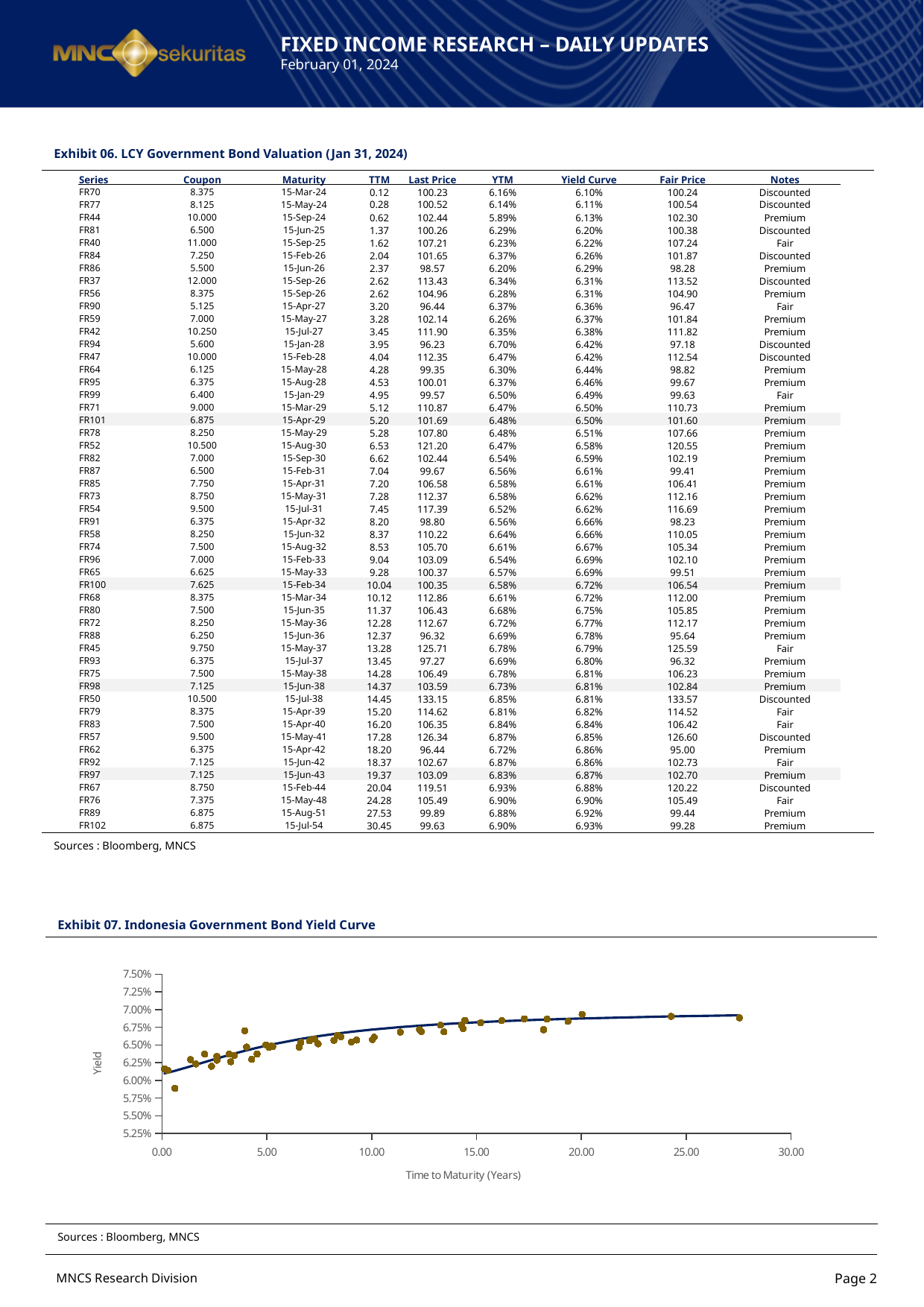
In Exhibit 07, is the fitted yield curve at 10 years to maturity greater or less than 6.25%? greater In Exhibit 07, is the yield of the outlying point near 4 years to maturity greater or less than 6.50%? greater In Exhibit 07, is the fitted yield curve at 25 years to maturity greater or less than 7.00%? less What is the title of the chart on the slide? Exhibit 07. Indonesia Government Bond Yield Curve In Exhibit 07, which has the higher yield: the point near 0.5 years to maturity or the point near 27.5 years to maturity? The point near 27.5 years What is the label of the x axis in Exhibit 07? Time to Maturity (Years) What kind of chart is Exhibit 07? Scatter chart with a fitted curve In Exhibit 07, do yields generally rise or fall as time to maturity increases? Rise What is the highest value shown on the y axis of Exhibit 07? 7.50%